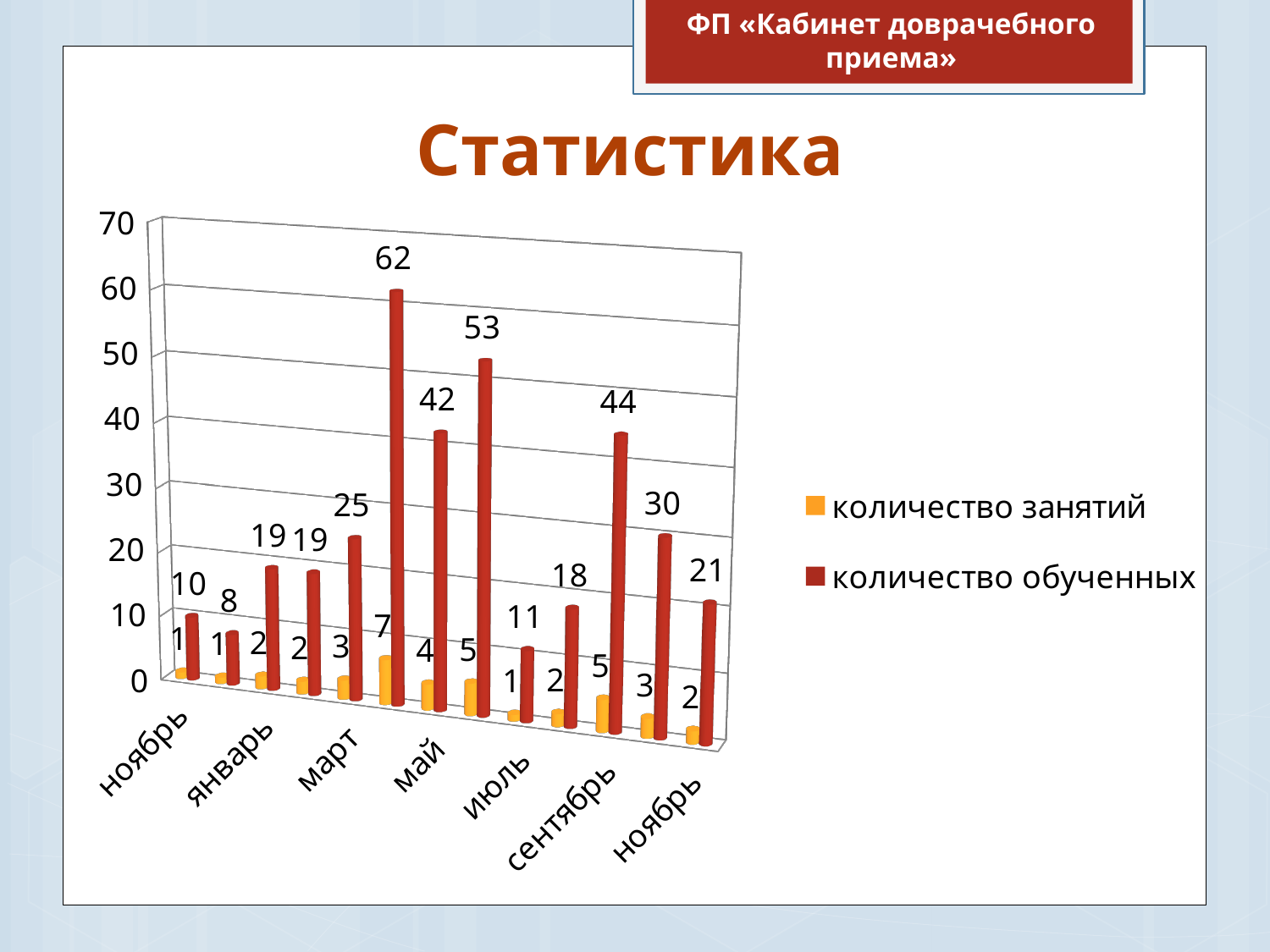
What is the value of количество обученных for the last ноябрь on the x axis? 21 What is the value of количество обученных for март? 25 How many series does the legend list? 2 What is the lowest value shown for количество обученных? 8 What kind of chart is shown on the slide? bar chart What is the title of the slide above the chart? Статистика What is the value of количество обученных for май? 42 What is the value of количество занятий for сентябрь? 5 What is the difference between количество обученных for сентябрь and for июль? 33 Which is larger, количество обученных for январь or for май? май How many bars does the количество обученных series have? 13 What is the highest value shown for количество обученных? 62